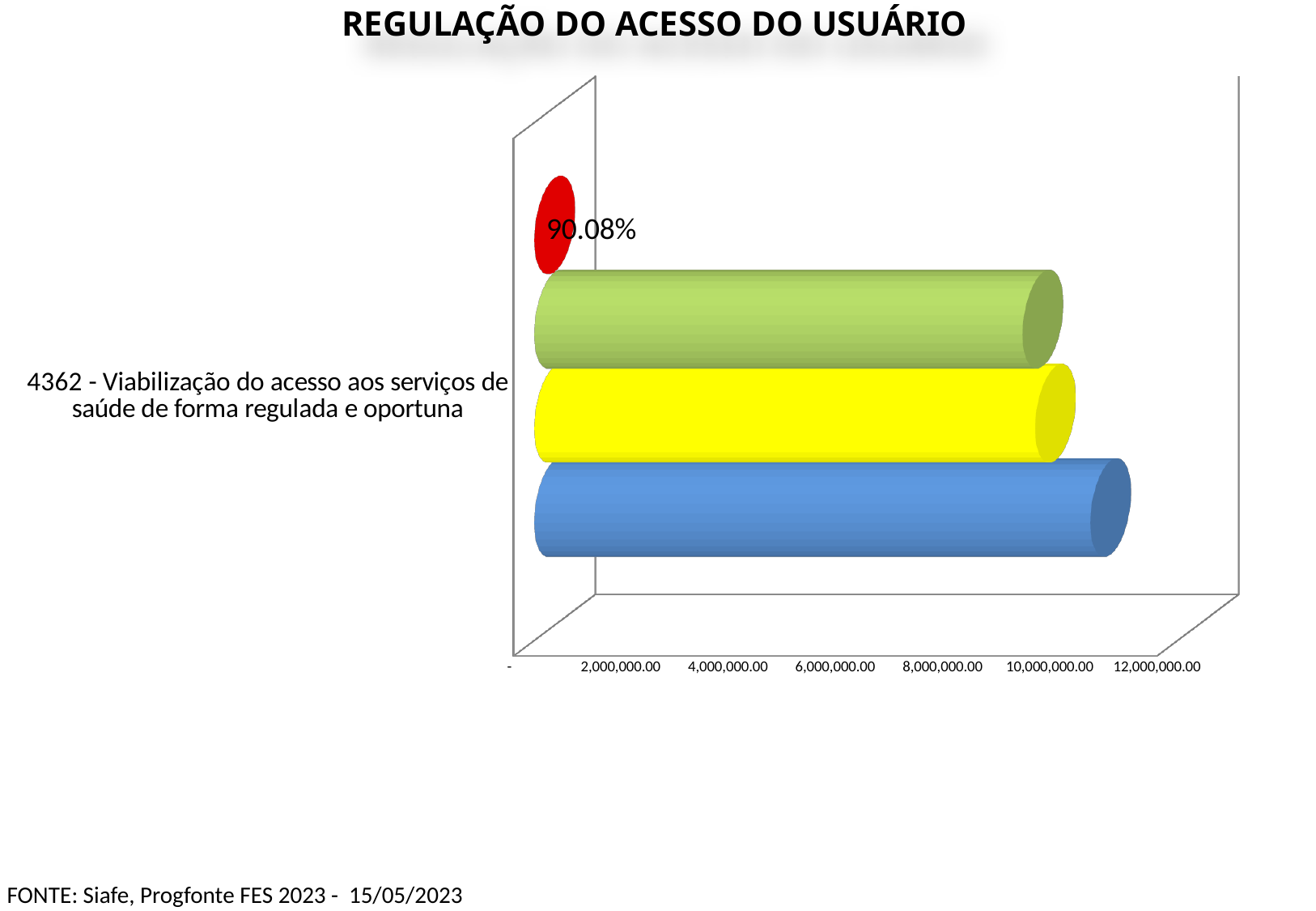
What percentage value is printed on the chart? 90.08% Is the blue bar longer or shorter than the green bar? longer Is the value of the blue bar greater or less than 8,000,000.00? greater Which coloured bar is the longest on the chart? blue What kind of chart is shown on the slide? bar chart What is the title of the chart? REGULAÇÃO DO ACESSO DO USUÁRIO Is the value of the yellow bar greater or less than 4,000,000.00? greater How many categories are shown on the chart's category axis? 1 Is the value of the green bar greater or less than 6,000,000.00? greater How many bars are plotted for the category on the chart? 4 What is the label of the category shown on the chart? 4362 - Viabilização do acesso aos serviços de saúde de forma regulada e oportuna What is the highest tick value shown on the value axis? 12,000,000.00